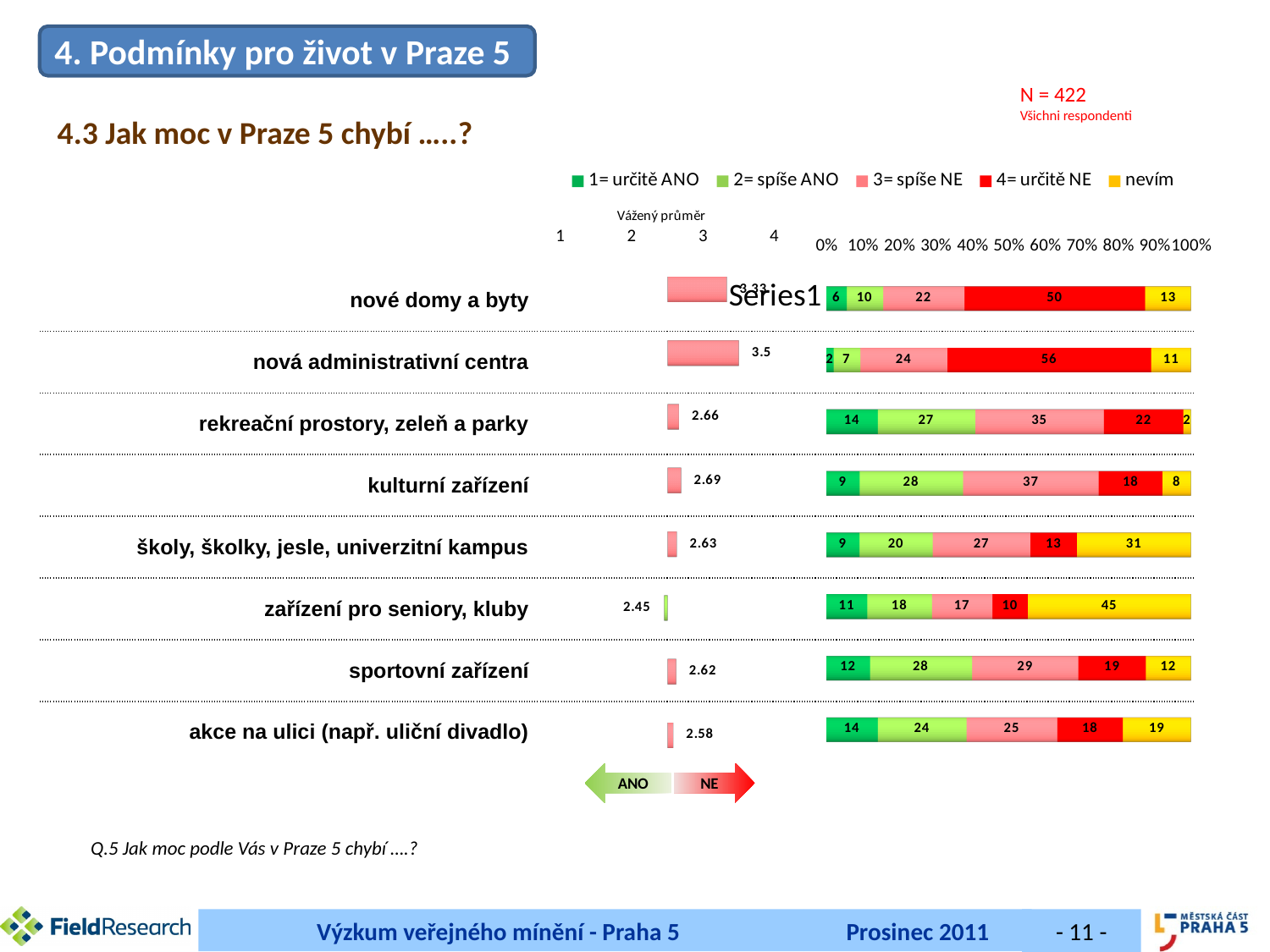
In the stacked bar chart on the right, which is larger: the '1= určitě ANO' value for 'rekreační prostory, zeleň a parky' or for 'kulturní zařízení'? rekreační prostory, zeleň a parky In the weighted average chart (Vážený průměr), is the value for 'nová administrativní centra' greater or less than 3? greater What type of chart is the chart on the right of the slide? stacked bar chart How many categories are shown in the stacked bar chart on the right? 8 In the weighted average chart (Vážený průměr), which category has the highest value? nová administrativní centra In the stacked bar chart on the right, what is the value of 'nevím' for 'zařízení pro seniory, kluby'? 45 How many series does the legend of the stacked bar chart list? 5 In the stacked bar chart on the right, what is the value of '4= určitě NE' for 'nová administrativní centra'? 56 In the stacked bar chart on the right, what is the difference between the '3= spíše NE' values for 'kulturní zařízení' and 'sportovní zařízení'? 8 In the weighted average chart (Vážený průměr), which category has the lowest value? zařízení pro seniory, kluby In the weighted average chart (Vážený průměr), what is the value for 'kulturní zařízení'? 2.69 In the stacked bar chart on the right, which category has the highest value for '4= určitě NE'? nová administrativní centra